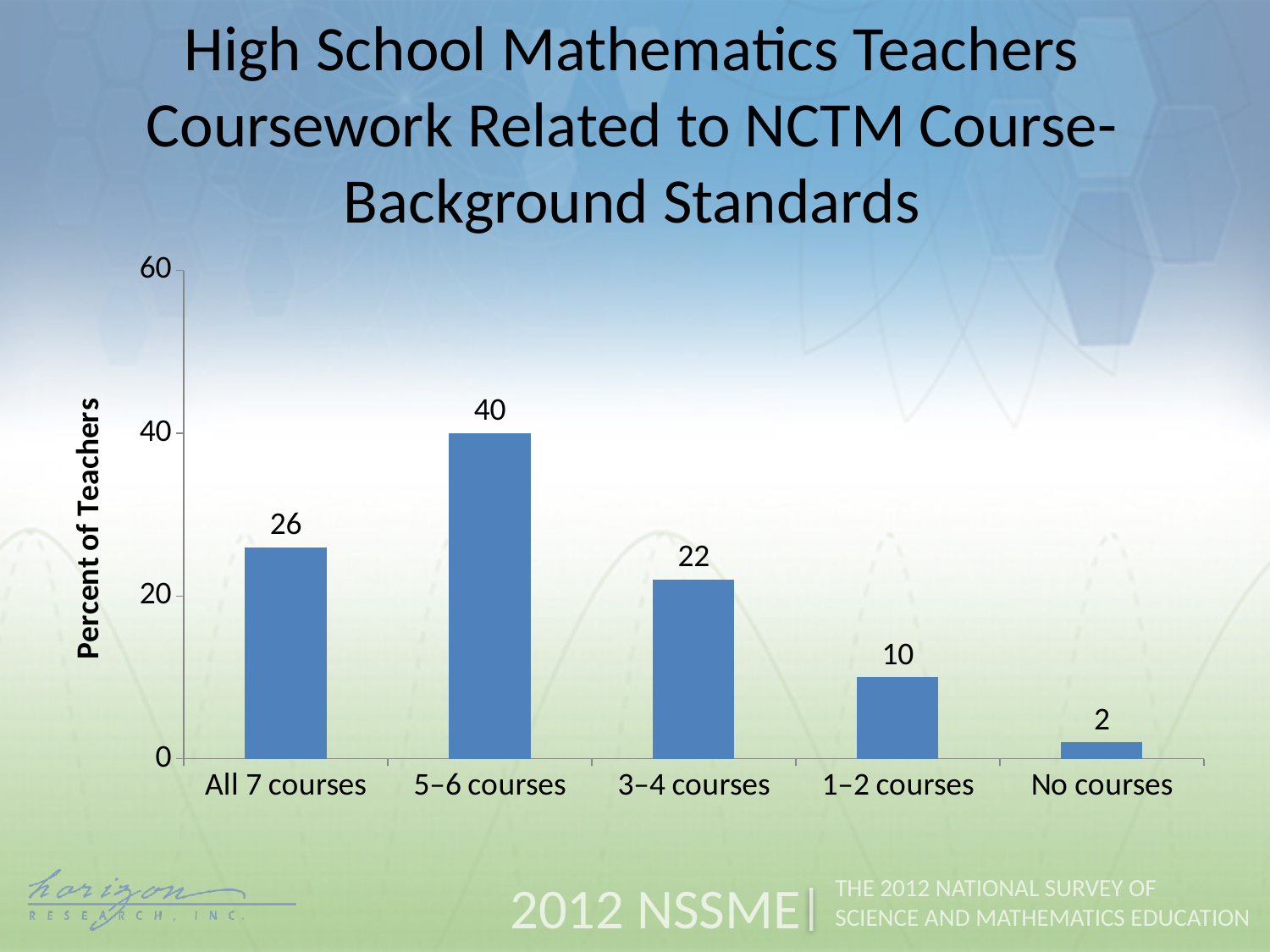
Which category has the highest percent of teachers? 5–6 courses What is the difference between the values for 5–6 courses and 3–4 courses? 18 Which category has the lowest percent of teachers? No courses How many categories are shown on the x axis? 5 Is the value for 1–2 courses greater or less than 20? less What is the value for the 5–6 courses category? 40 Which is larger, the value for All 7 courses or the value for 3–4 courses? All 7 courses What percent of teachers took all 7 courses? 26 What is the label of the y axis? Percent of Teachers What percent of teachers took no courses? 2 What kind of chart is shown on the slide? Bar chart What is the difference between the values for All 7 courses and 1–2 courses? 16